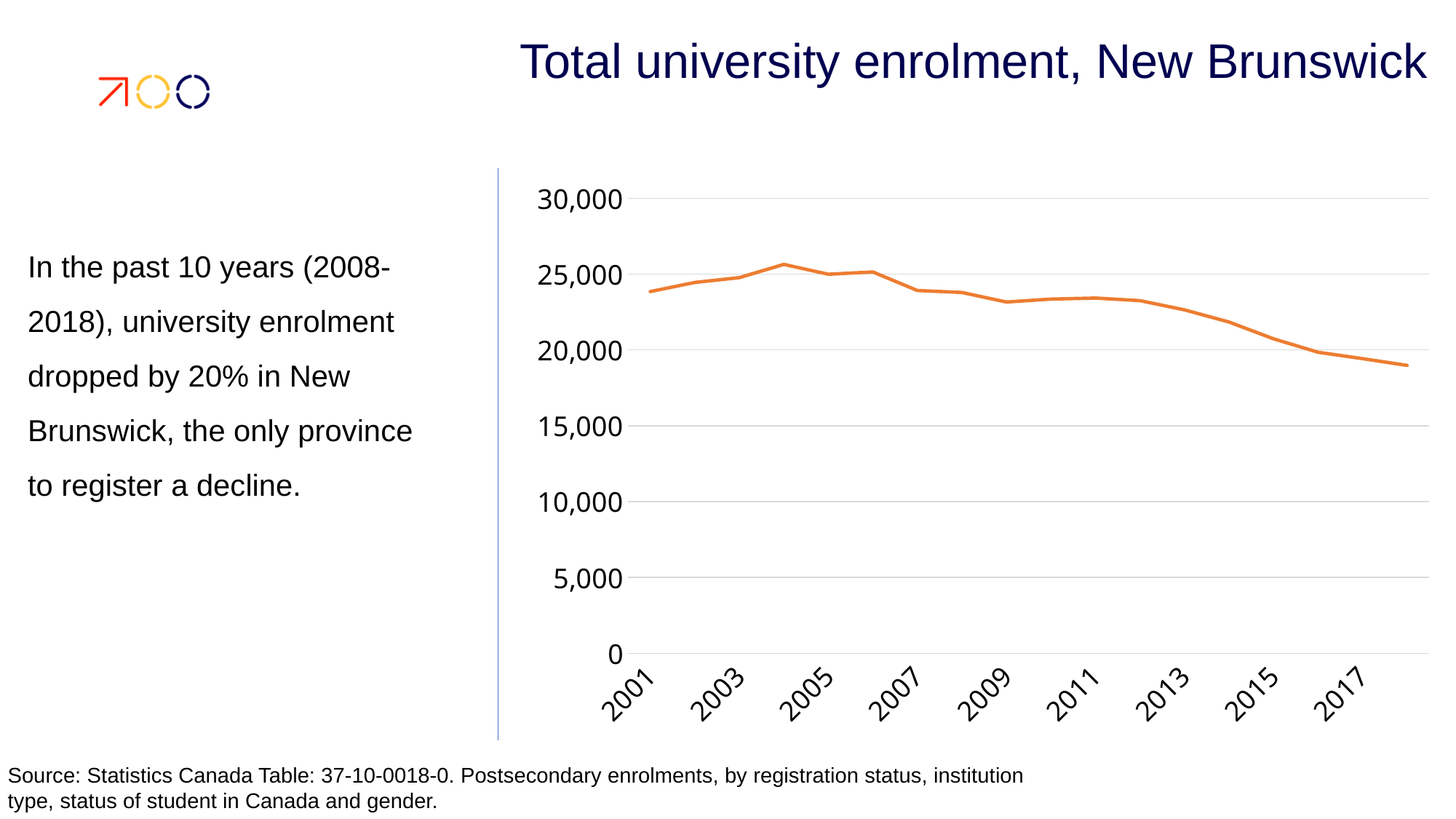
Is the value for 2017 greater or less than 20,000? less What is the title of the chart? Total university enrolment, New Brunswick Is the value for 2013 greater or less than 20,000? greater Do the values generally rise or fall from 2009 to 2017? fall How many year labels are shown on the x axis? 9 What kind of chart is shown on the slide? line chart Is the value for 2001 greater or less than 25,000? less Which is larger, the value for 2001 or the value for 2017? 2001 What is the highest value shown on the y axis? 30,000 Which year has the highest enrolment on the chart? 2004